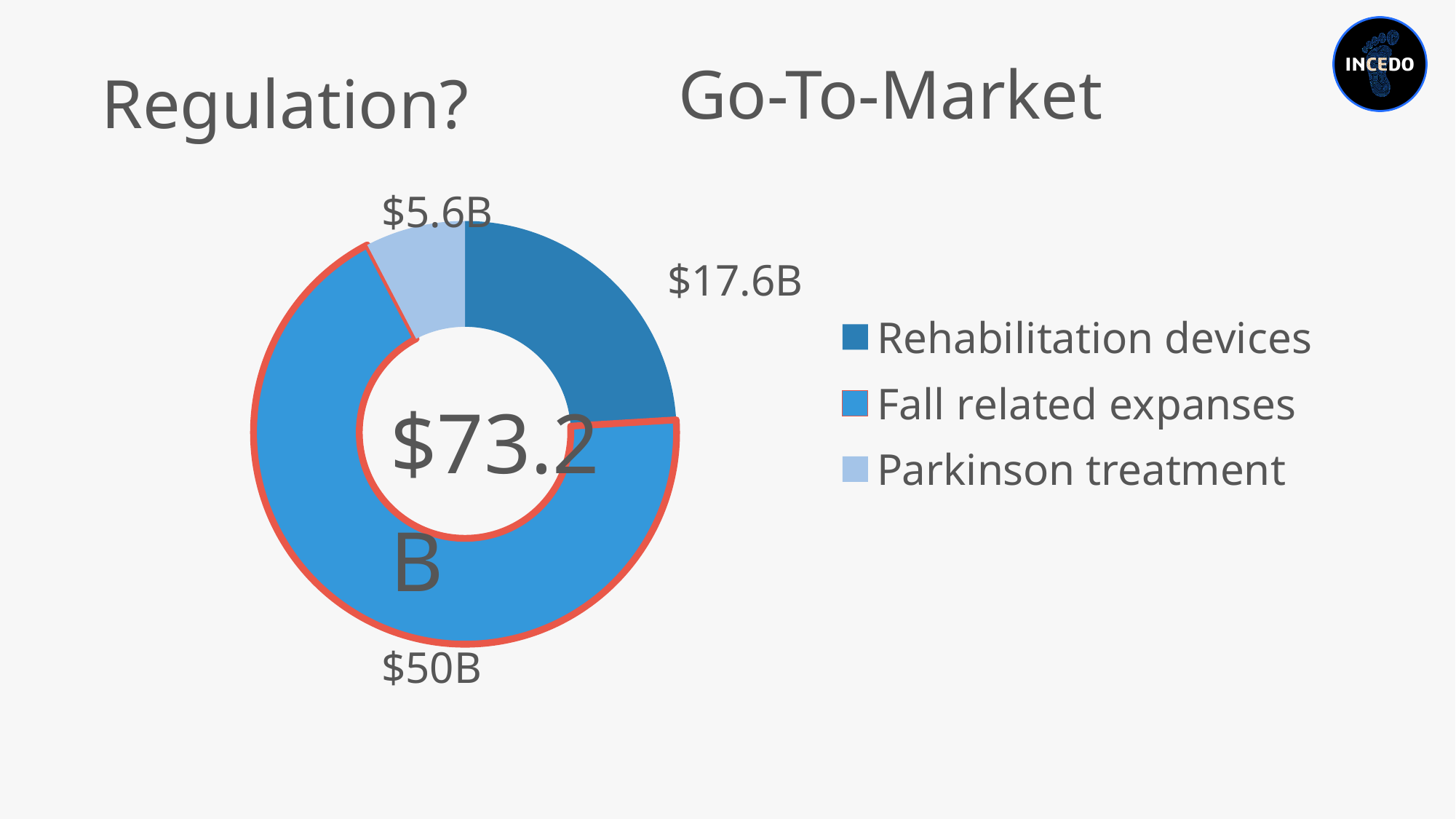
How many categories does the doughnut chart show? 3 What kind of chart is shown on the slide? Doughnut chart What is the value for Parkinson treatment in the doughnut chart? $5.6B What is the value for Fall related expanses in the doughnut chart? $50B Which legend entry is shown with the lightest blue colour? Parkinson treatment What is the value for Rehabilitation devices in the doughnut chart? $17.6B What is the difference between the values for Rehabilitation devices and Parkinson treatment? $12B Which is larger, the value for Rehabilitation devices or the value for Parkinson treatment? Rehabilitation devices Which category has the smallest slice in the doughnut chart? Parkinson treatment Which category has the largest slice in the doughnut chart? Fall related expanses What total value is shown in the centre of the doughnut chart? $73.2B What is the difference between the values for Fall related expanses and Rehabilitation devices? $32.4B